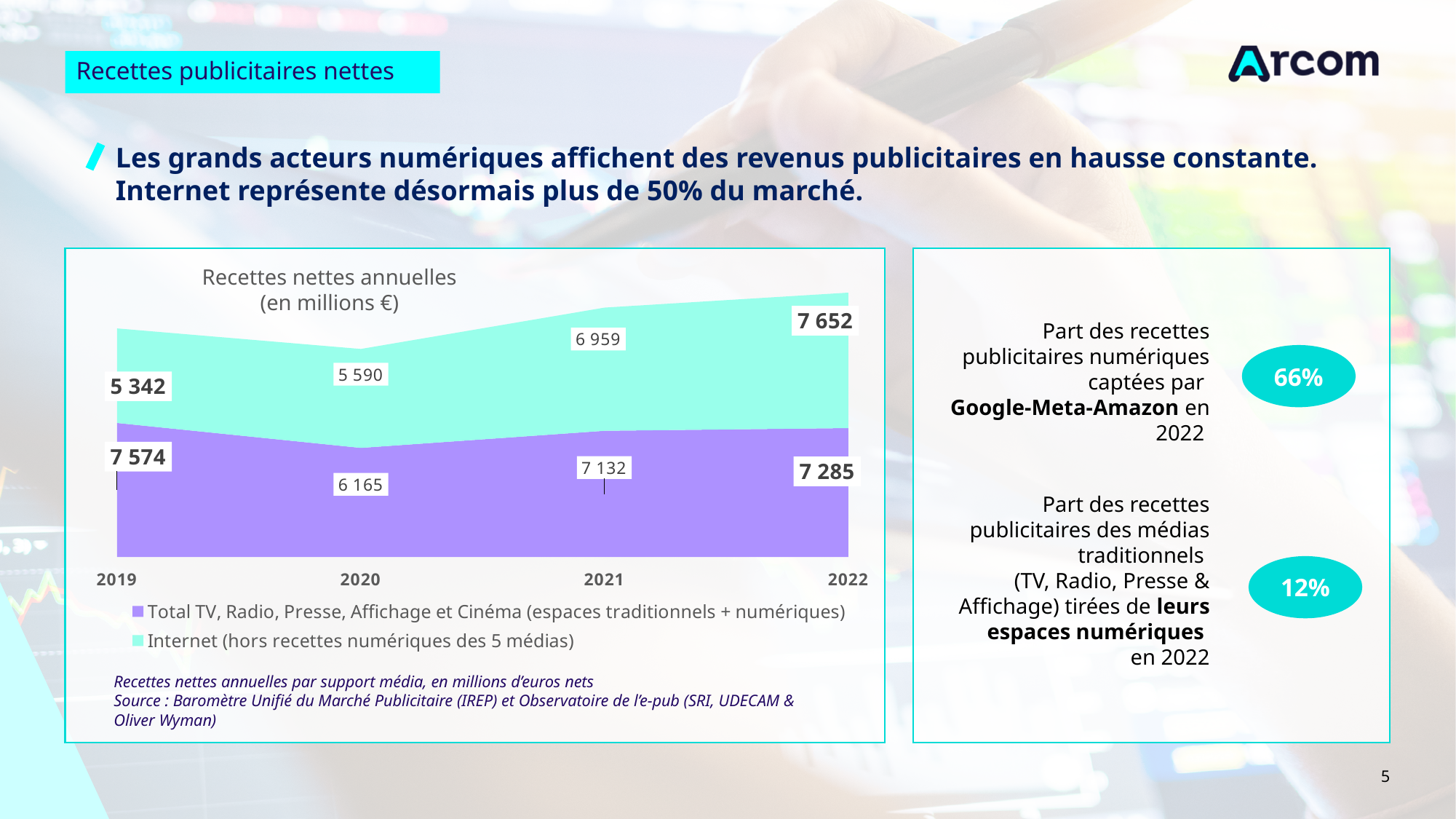
Which is larger in 2022: the Internet value or the 'Total TV, Radio, Presse, Affichage et Cinéma' value? Internet What is the Internet value for 2019? 5 342 What is the combined total of the two series in 2021? 14 091 How many series does the chart legend list? 2 What is the difference between the Internet values for 2022 and 2021? 693 What is the Internet value for 2022 in the 'Recettes nettes annuelles' chart? 7 652 In which year is the Internet series lowest? 2019 In which year is the 'Total TV, Radio, Presse, Affichage et Cinéma' series highest? 2019 Does the Internet series rise or fall from 2019 to 2022? Rise What kind of chart is 'Recettes nettes annuelles'? Stacked area chart What is the value for 'Total TV, Radio, Presse, Affichage et Cinéma' in 2020? 6 165 How many years are shown on the x axis of the chart? 4